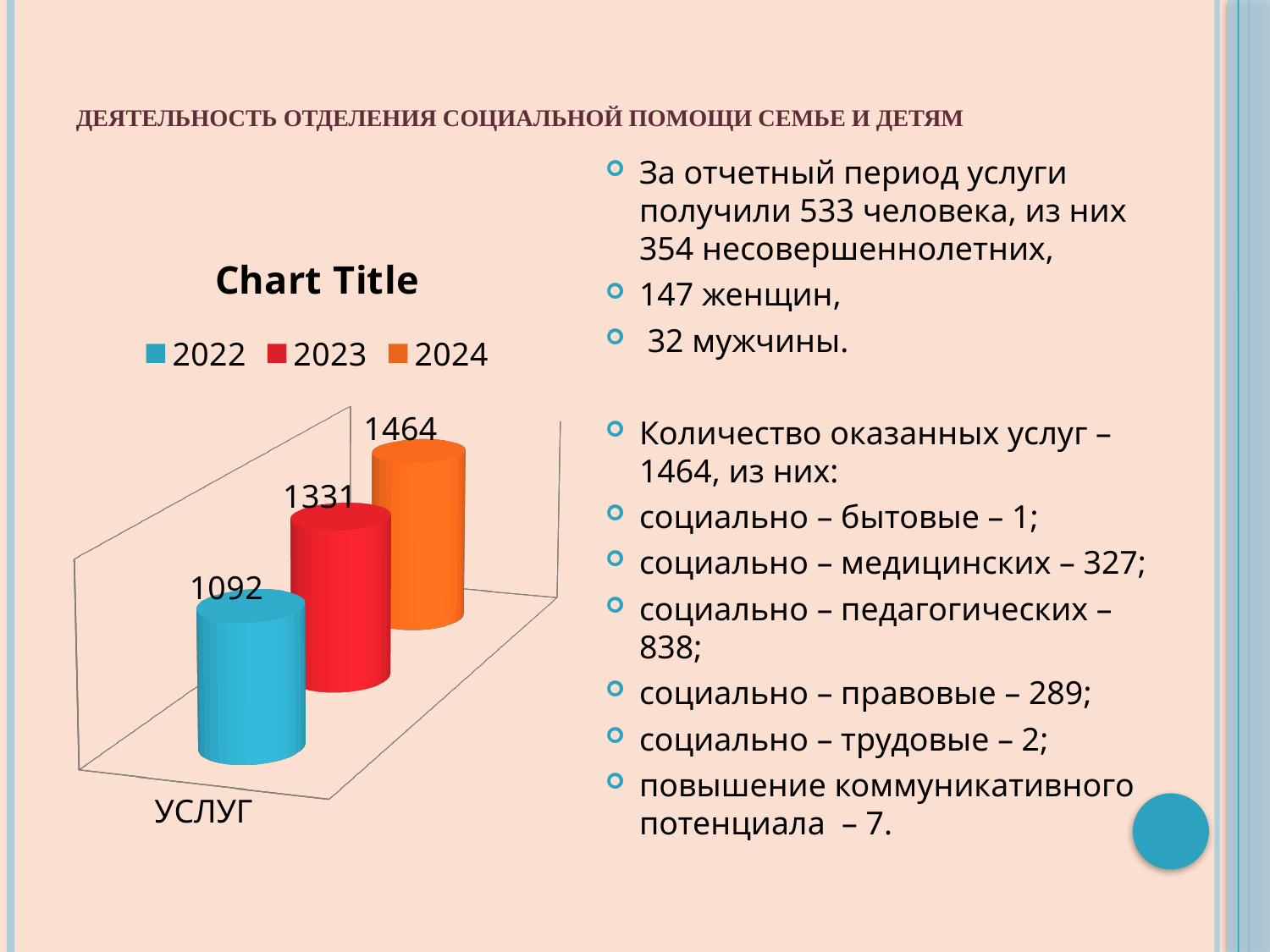
What is the difference between the values for 2023 and 2022? 239 What is the value for 2022 in the chart? 1092 What is the category label shown on the x axis of the chart? УСЛУГ Which year has the lowest value in the chart? 2022 Which year has the highest value in the chart? 2024 What kind of chart is shown on the slide? bar chart What is the value for 2024 in the chart? 1464 How many series does the legend list? 3 What is the difference between the values for 2024 and 2022? 372 What is the value for 2023 in the chart? 1331 Do the values rise or fall from 2022 to 2024? rise Which is larger, the value for 2023 or the value for 2024? 2024